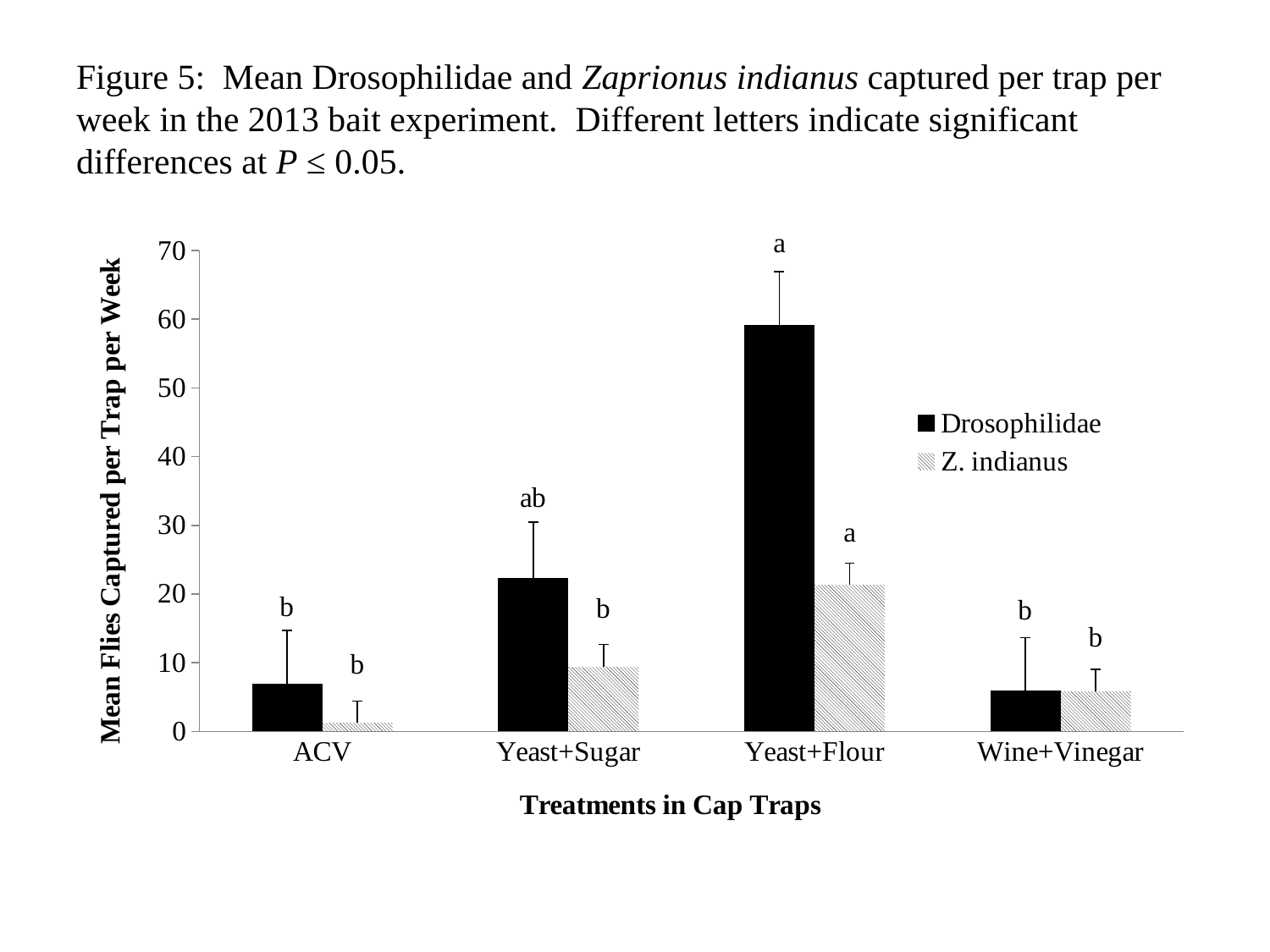
Which treatment has the lowest Z. indianus value? ACV What kind of chart is shown on the slide? bar chart Is the Z. indianus value for Yeast+Flour greater or less than 10? greater Which treatment has the highest Z. indianus value? Yeast+Flour Which treatment has the highest Drosophilidae value? Yeast+Flour How many series does the legend list? 2 Is the Z. indianus value for Wine+Vinegar greater or less than 10? less Is the Drosophilidae value for ACV greater or less than 10? less How many treatment categories are shown on the x axis? 4 What is the label of the y axis? Mean Flies Captured per Trap per Week For Yeast+Flour, which series has the larger value, Drosophilidae or Z. indianus? Drosophilidae